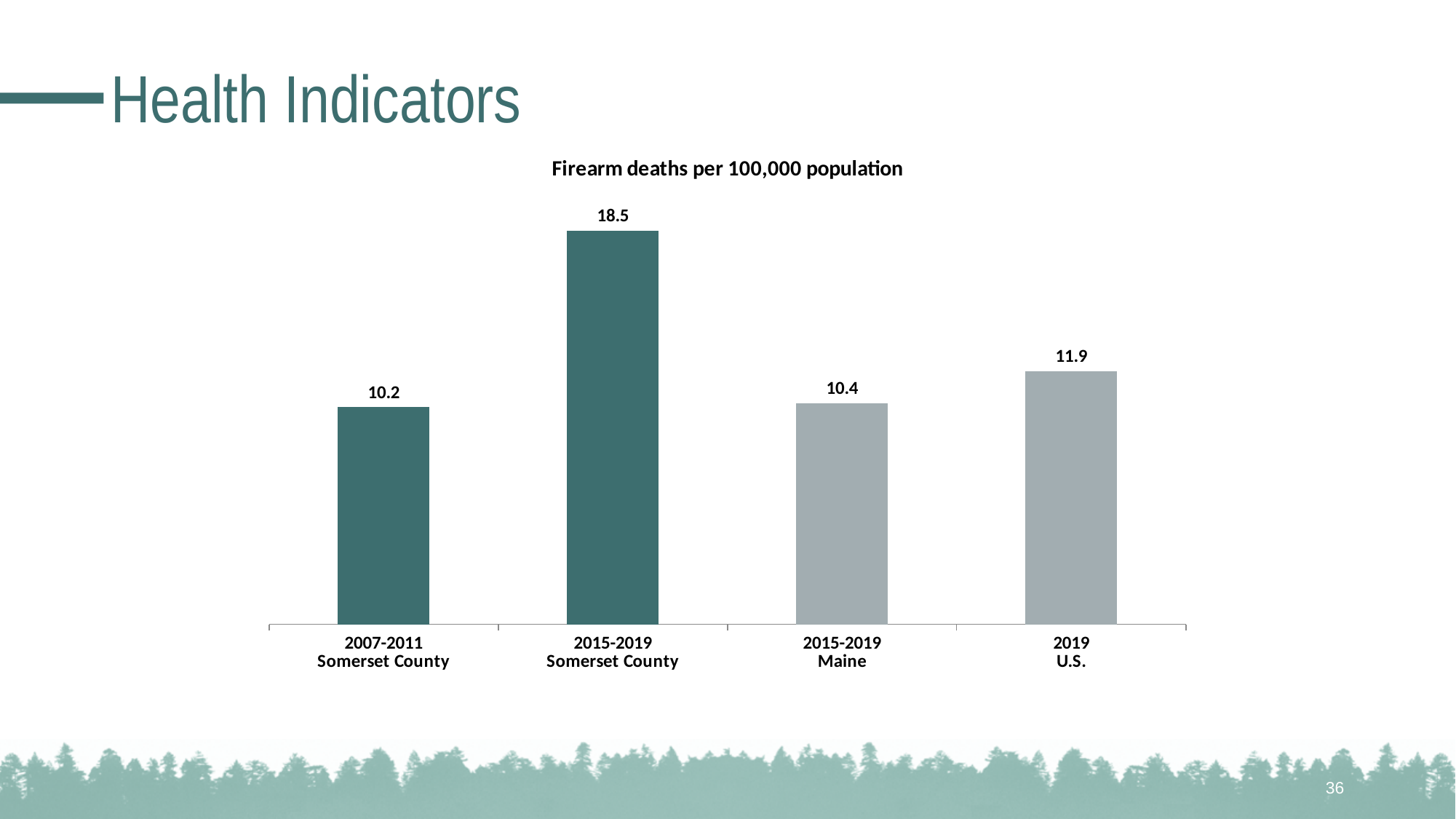
What is the value for 2015-2019 Somerset County? 18.5 What is the value for 2015-2019 Maine? 10.4 What is the value for 2007-2011 Somerset County? 10.2 What kind of chart is shown on the slide? Bar chart What is the difference between the 2015-2019 Somerset County value and the 2015-2019 Maine value? 8.1 What is the title of the chart? Firearm deaths per 100,000 population Which category has the lowest firearm death rate? 2007-2011 Somerset County What is the difference between the 2015-2019 Somerset County value and the 2007-2011 Somerset County value? 8.3 Which is larger, the value for 2019 U.S. or the value for 2015-2019 Maine? 2019 U.S. How many categories are shown in the chart? 4 Which category has the highest firearm death rate? 2015-2019 Somerset County What is the value for 2019 U.S.? 11.9